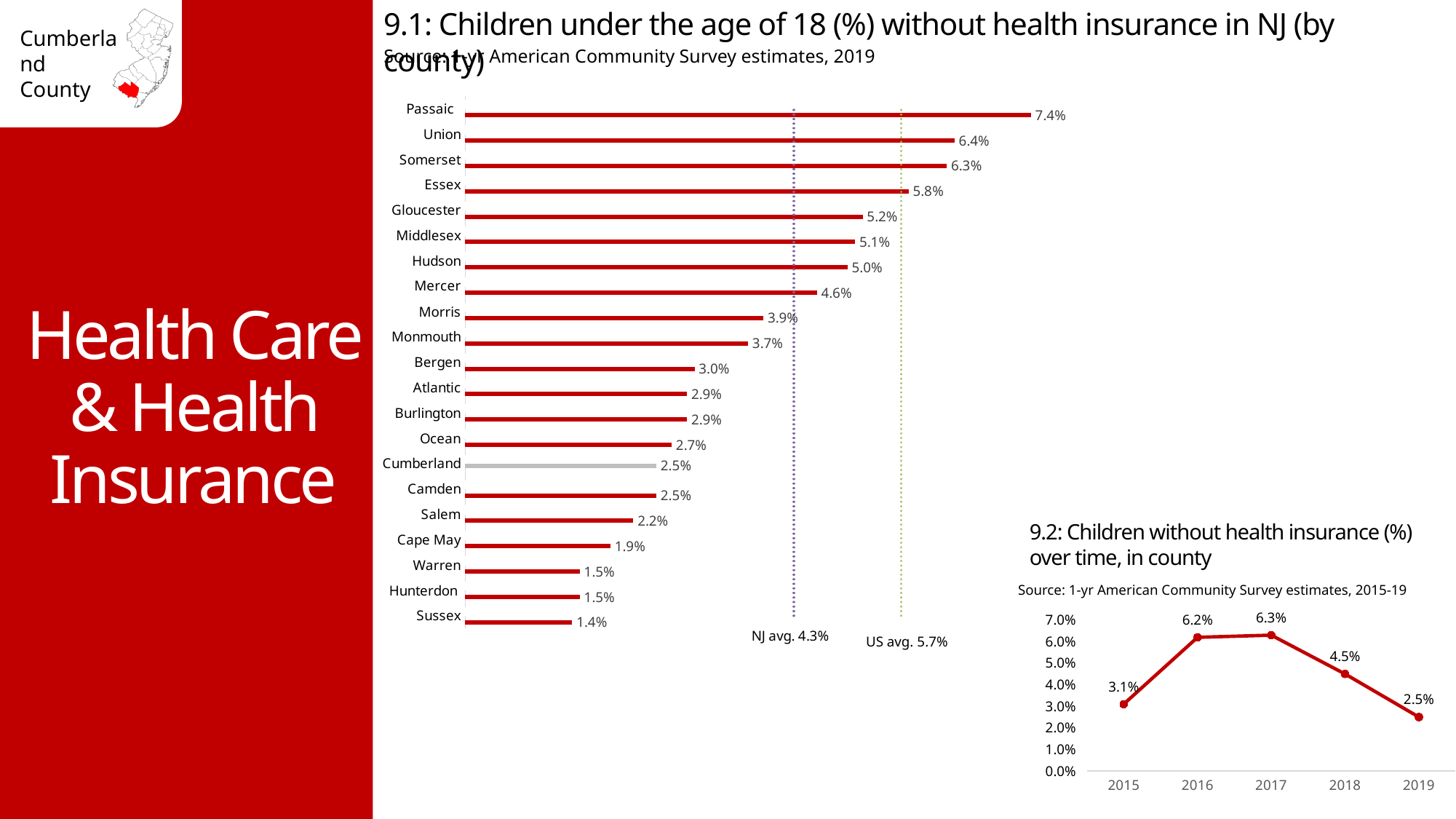
In chart 9.1, what is the value for Hudson? 5.0% In chart 9.1, what is the difference between the values for Passaic and Sussex? 6.0% In chart 9.2, do the values rise or fall from 2017 to 2019? Fall In chart 9.2, what is the value for 2017? 6.3% In chart 9.1, how many counties are plotted? 21 In chart 9.1, which county has a larger value, Gloucester or Mercer? Gloucester In chart 9.2, what is the difference between the values for 2017 and 2019? 3.8% In chart 9.1, what NJ average is marked by the dotted reference line? 4.3% What kind of chart is chart 9.2 (children without health insurance over time, in county)? Line chart In chart 9.1, which county has the lowest percentage of children without health insurance? Sussex In chart 9.1, which county has the highest percentage of children without health insurance? Passaic In chart 9.1 (children under 18 without health insurance by county), what is the value for Cumberland? 2.5%